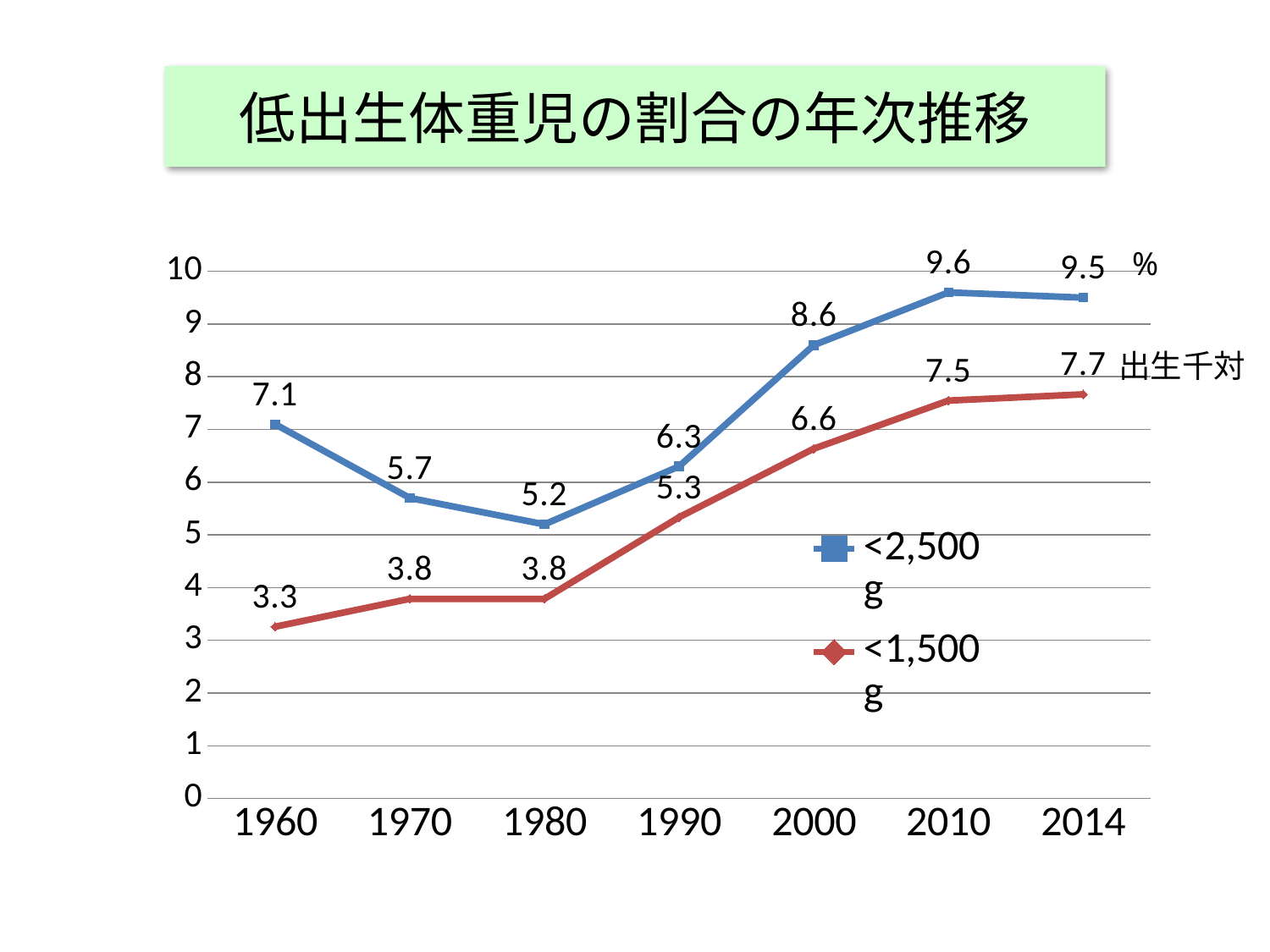
What is the difference between the <2,500 g and <1,500 g values in 2010? 2.1 Which is larger in 1990: the <2,500 g value or the <1,500 g value? <2,500 g What is the value for <1,500 g in 2014? 7.7 What is the value for <2,500 g in 2000? 8.6 In which year is the <2,500 g series highest? 2010 What is the title of the chart? 低出生体重児の割合の年次推移 How many series does the legend list? 2 What is the value for <2,500 g in 1960? 7.1 In which year is the <1,500 g series lowest? 1960 What kind of chart is shown on the slide? Line chart How many years are shown on the x axis? 7 Does the <1,500 g series rise or fall from 1980 to 2014? Rise